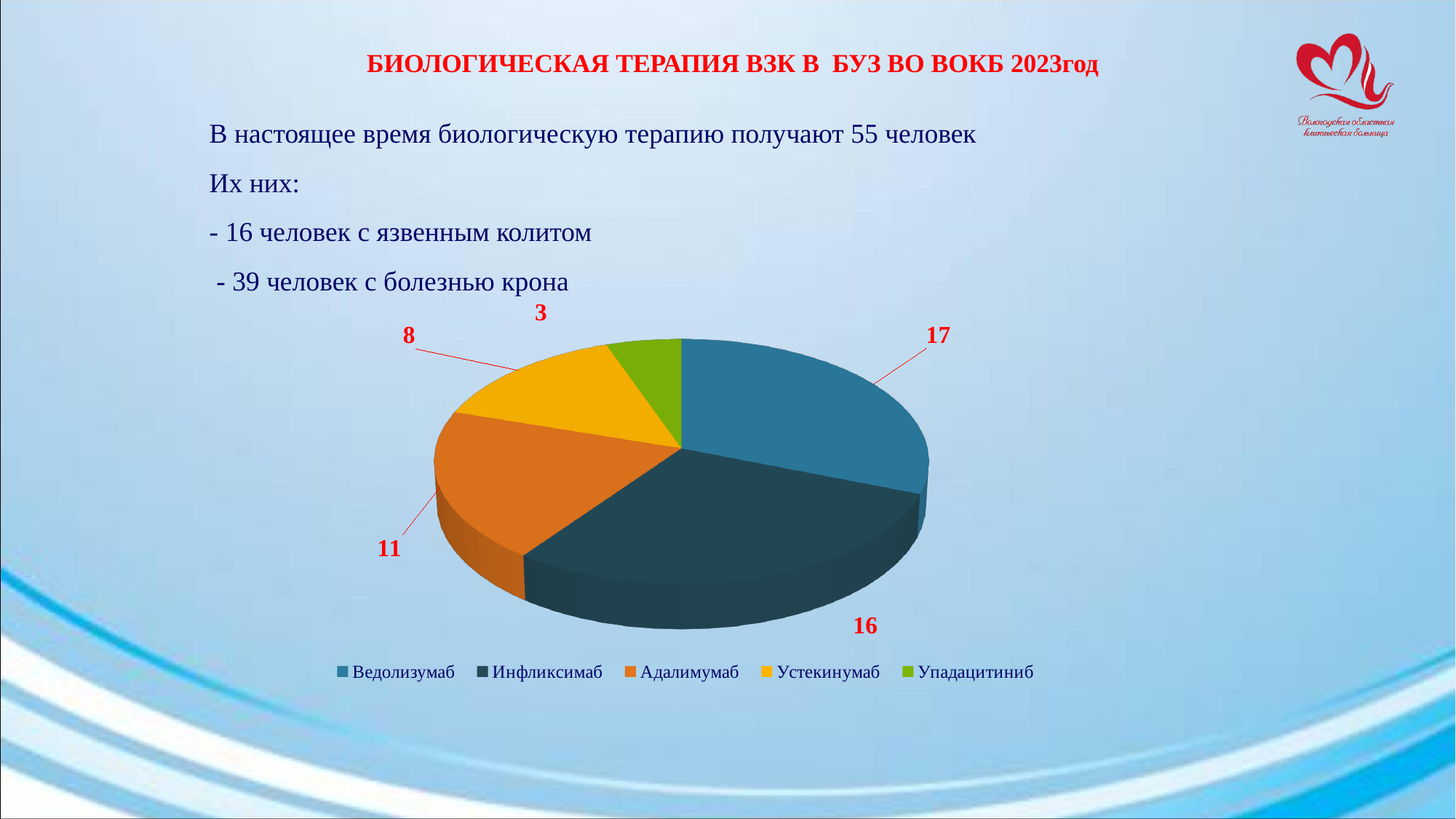
Which is larger, the value for Адалимумаб or the value for Устекинумаб? Адалимумаб Which category has the smallest slice of the pie? Упадацитиниб How many slices does the pie chart have? 5 What kind of chart is shown on the slide? Pie chart What is the difference between the values for Ведолизумаб and Устекинумаб? 9 What is the value for Инфликсимаб? 16 What is the value for Устекинумаб? 8 What share of the pie does Адалимумаб represent? 20% What is the value for Адалимумаб? 11 Which category has the largest slice of the pie? Ведолизумаб What is the value for Упадацитиниб? 3 What is the value for Ведолизумаб? 17